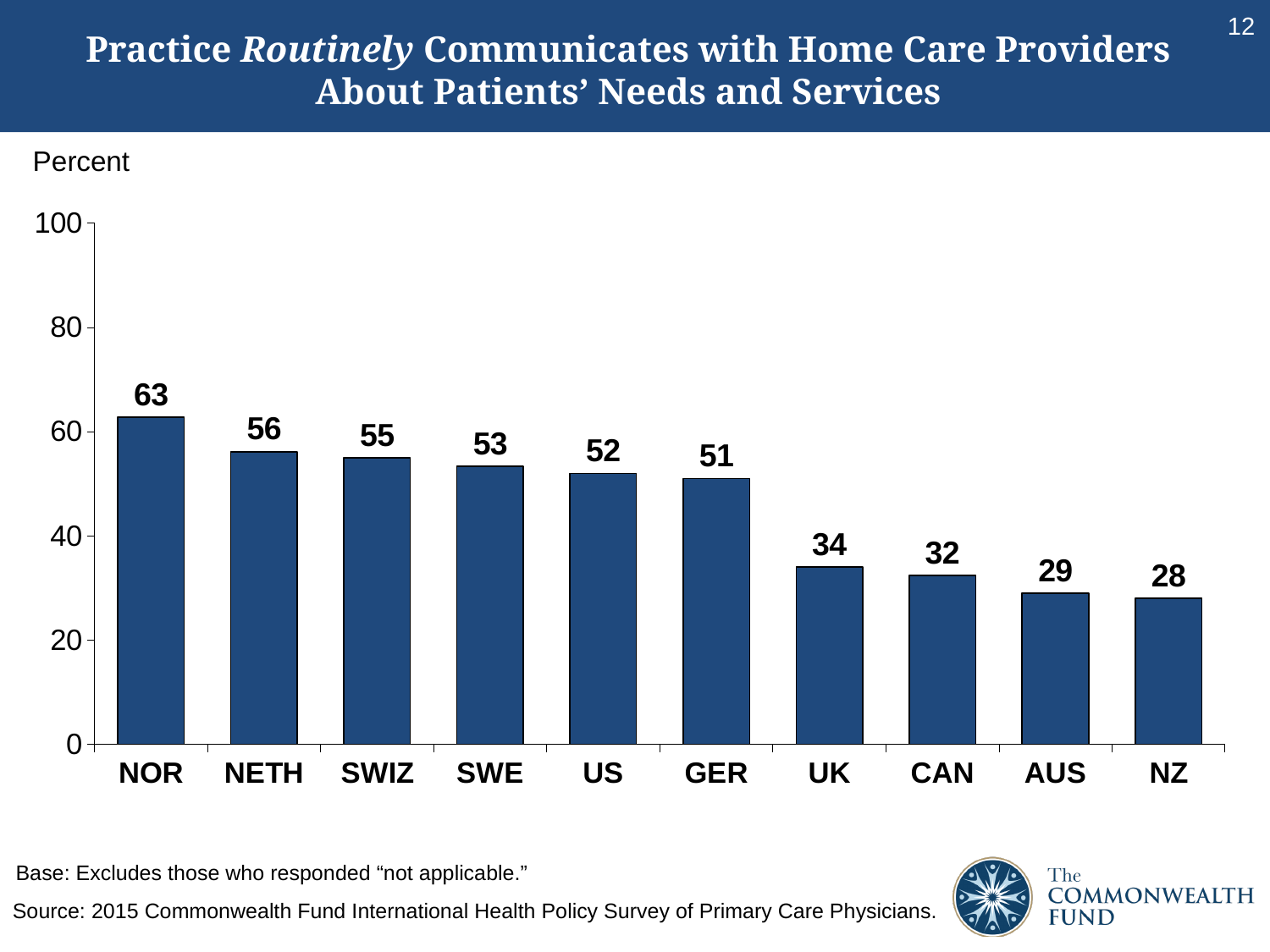
Is the value for UK greater or less than 40? less Which country has the lowest value? NZ What is the value for CAN? 32 Do the values rise or fall from left to right across the x axis? fall What kind of chart is shown on the slide? bar chart Which country has the highest value? NOR How many countries are shown on the chart? 10 What is the value for GER? 51 Which is larger, the value for SWE or the value for AUS? SWE What is the difference between the values for GER and UK? 17 What is the value for NOR? 63 What is the difference between the values for NOR and NZ? 35